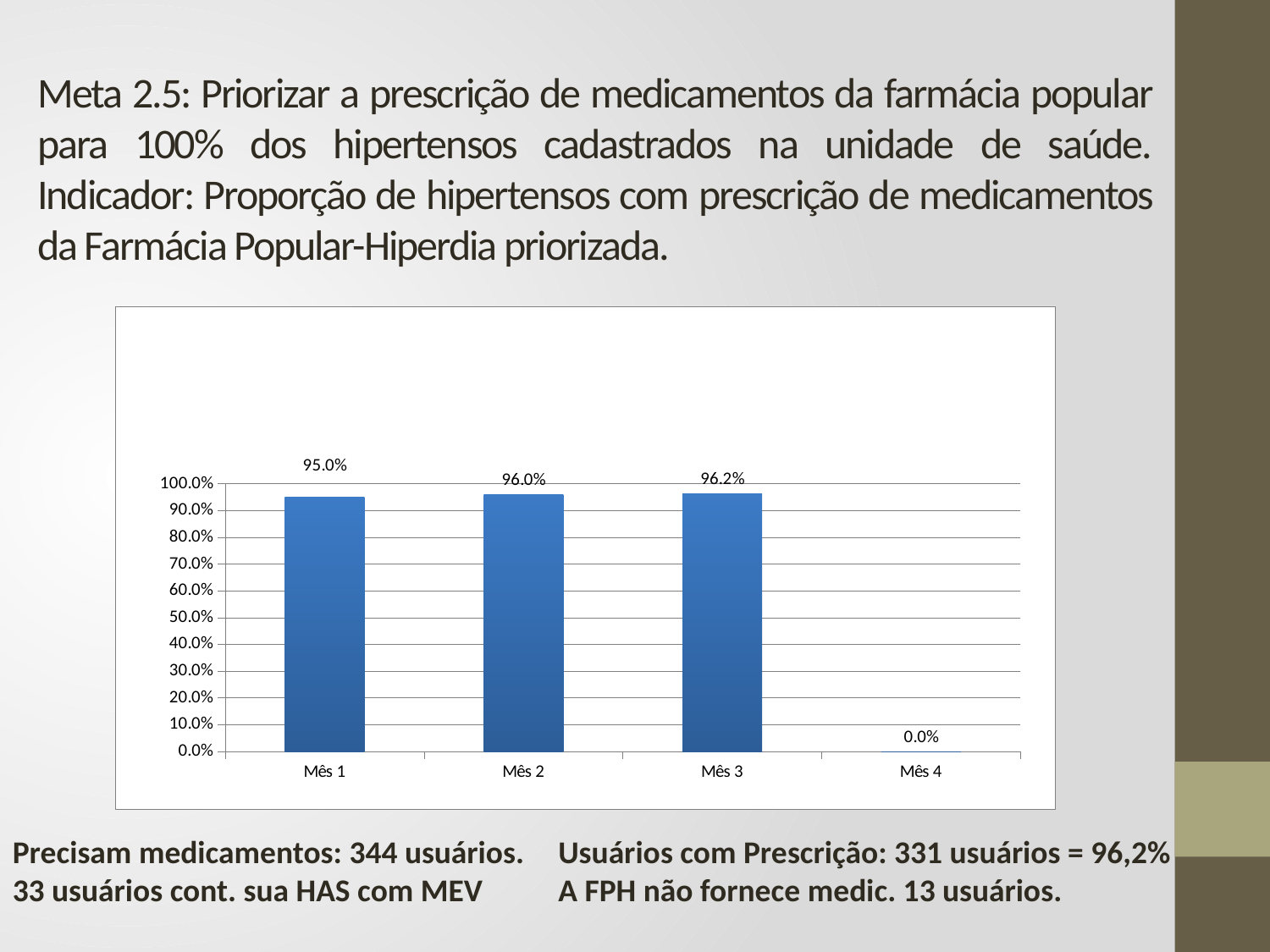
How many categories are shown on the x axis? 4 What is the difference between the values for Mês 3 and Mês 1? 1.2% Which category has the lowest value? Mês 4 What is the value for Mês 3? 96.2% What kind of chart is shown on the slide? bar chart What is the value for Mês 4? 0.0% What is the difference between the values for Mês 2 and Mês 1? 1.0% Which category has the highest value? Mês 3 Which is larger, the value for Mês 1 or the value for Mês 3? Mês 3 Is the value for Mês 2 greater or less than 90.0%? greater What is the value for Mês 2? 96.0% What is the value for Mês 1? 95.0%